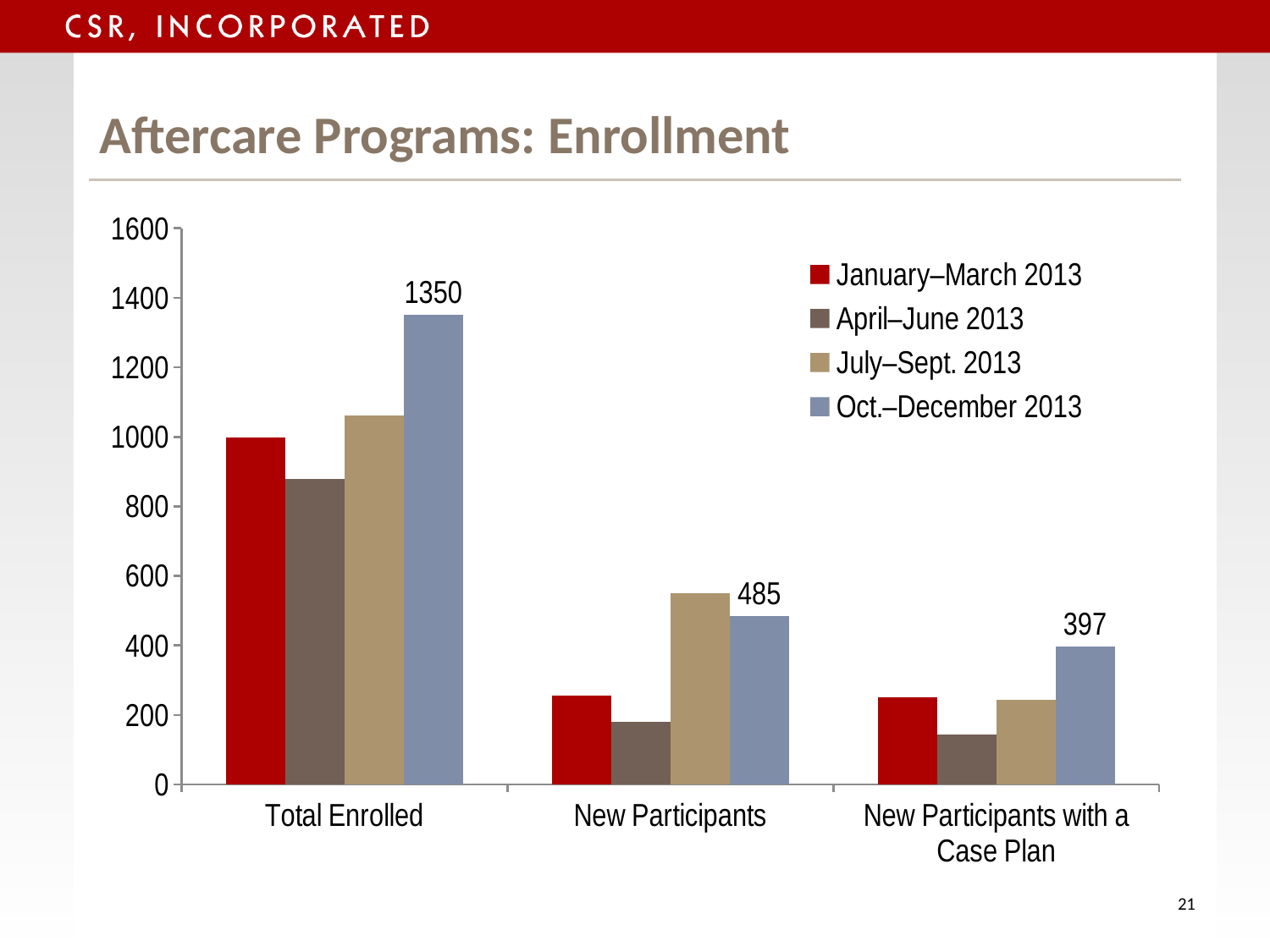
How many series does the legend list? 4 Which series has the highest value in the Total Enrolled category? Oct.–December 2013 What is the value for Oct.–December 2013 in the New Participants category? 485 Is the value for July–Sept. 2013 in the New Participants category greater or less than 400? greater What is the difference between the Oct.–December 2013 values for New Participants and New Participants with a Case Plan? 88 What is the value for Oct.–December 2013 in the New Participants with a Case Plan category? 397 Which series has the highest value in the New Participants category? July–Sept. 2013 What is the difference between the Oct.–December 2013 values for Total Enrolled and New Participants? 865 Is the value for April–June 2013 in the Total Enrolled category greater or less than 1000? less What is the value for Oct.–December 2013 in the Total Enrolled category? 1350 How many categories are shown on the x axis? 3 Which series has the lowest value in the Total Enrolled category? April–June 2013